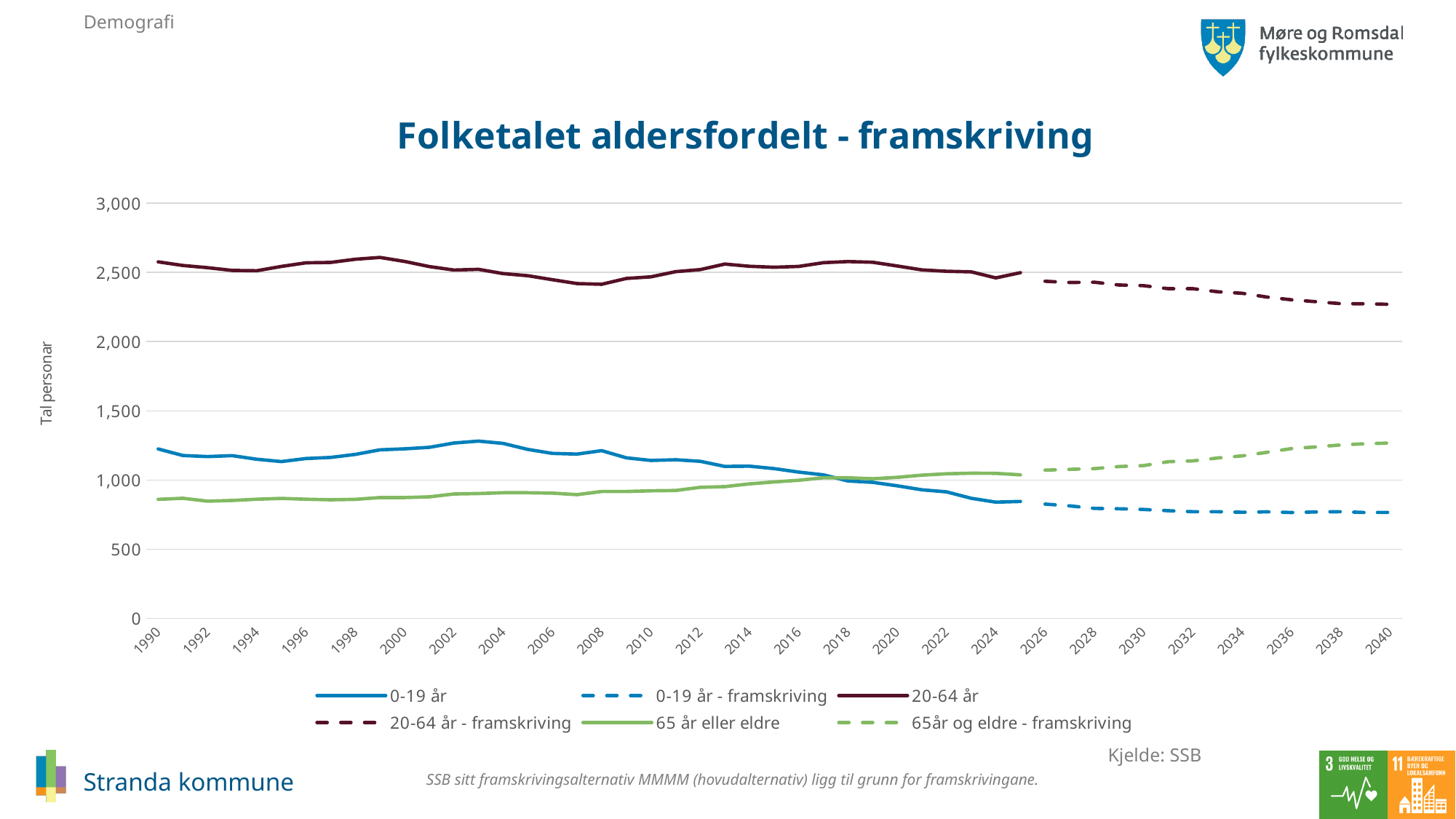
Is the value for 20-64 år in 1990 greater or less than 2,500? greater Is the value for 65 år eller eldre in 1990 greater or less than 1,000? less How many series does the legend list? 6 What kind of chart is shown on the slide? line chart What is the label on the vertical axis of the chart? Tal personar What is the title of the chart? Folketalet aldersfordelt - framskriving In 2040, which is larger: 0-19 år - framskriving or 65år og eldre - framskriving? 65år og eldre - framskriving Is the value for 20-64 år - framskriving in 2040 greater or less than 2,500? less Which series has the highest values across the whole chart? 20-64 år Does the 65år og eldre - framskriving series rise or fall from 2026 to 2040? rise